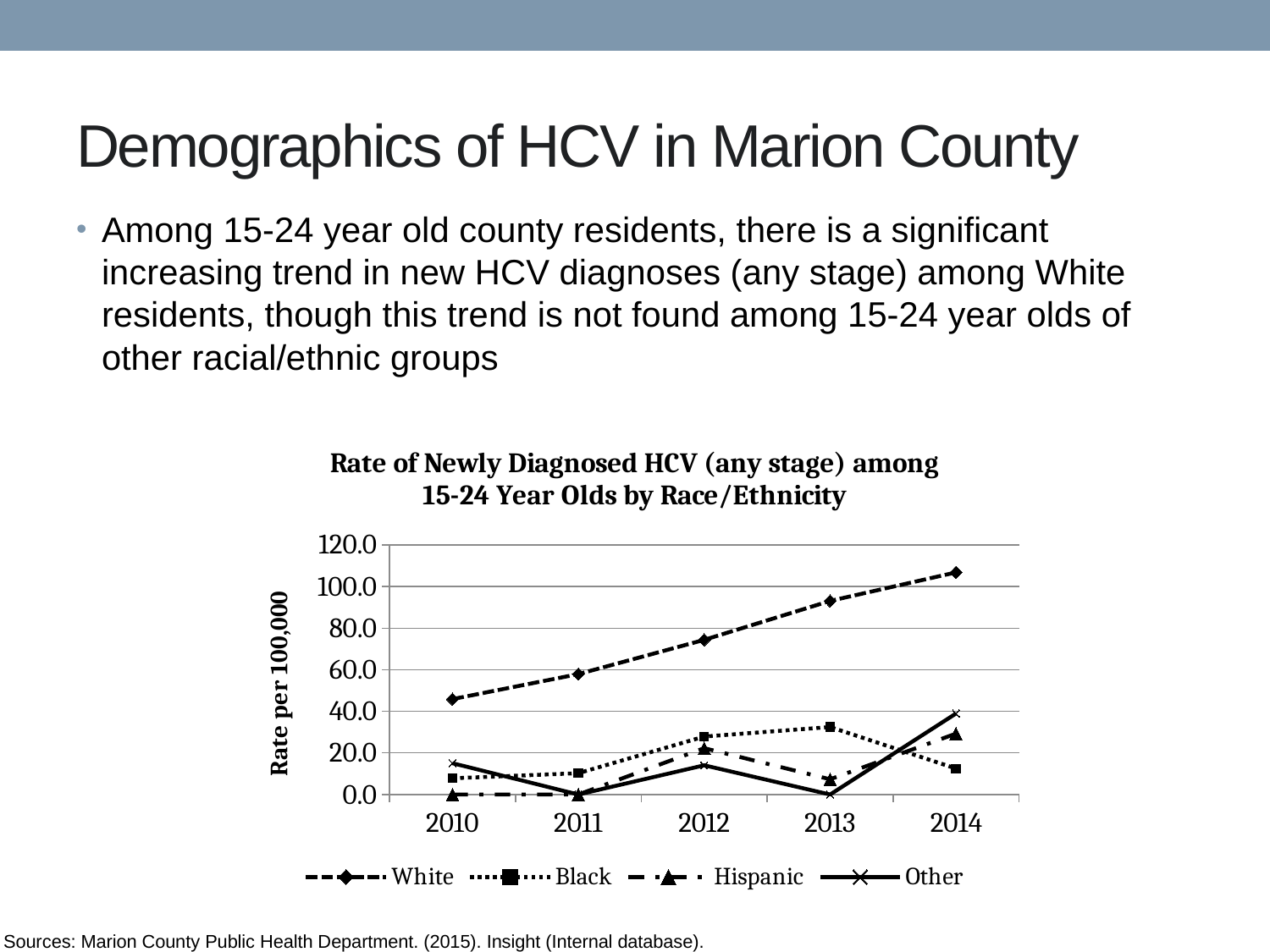
In which year is the rate for White residents highest? 2014 Which is larger in 2012, the rate for White or the rate for Black? White Is the value for White in 2014 greater or less than 100.0? greater Which series is drawn with a solid line and x markers? Other Does the rate for White residents rise or fall from 2010 to 2014? rise How many years are shown on the x axis? 5 In which year is the rate for White residents lowest? 2010 Is the value for Black in 2013 greater or less than 40.0? less How many series does the legend list? 4 Which racial/ethnic group has the highest rate in 2014? White What is the label on the y axis? Rate per 100,000 What kind of chart is shown on the slide? line chart